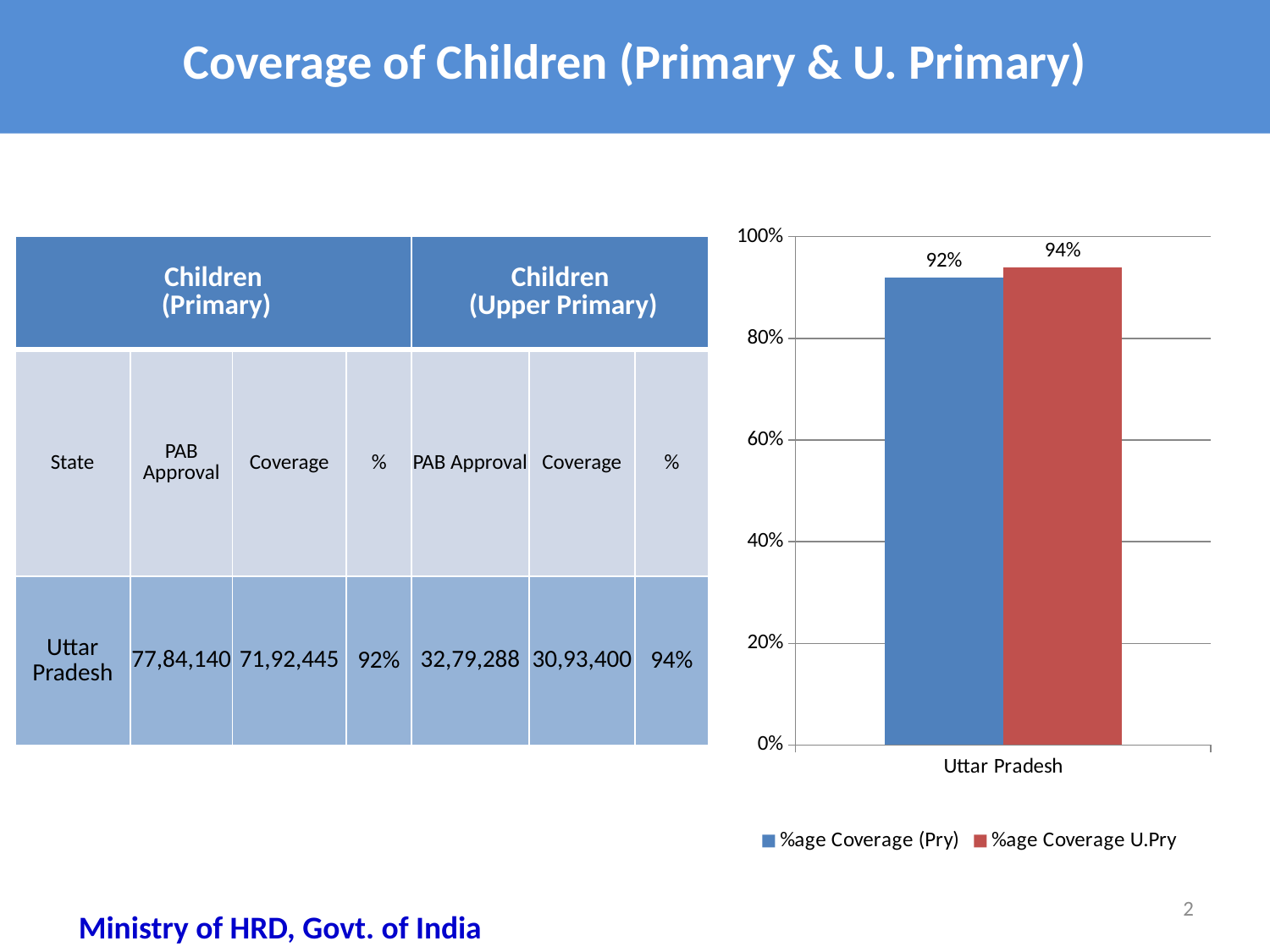
What colour is the bar for %age Coverage U.Pry in the chart? red What is the category label on the x axis of the chart? Uttar Pradesh What kind of chart is shown on the slide? bar chart Which series has the lower value for Uttar Pradesh in the chart? %age Coverage (Pry) How many series does the chart legend list? 2 How many categories are shown on the x axis of the chart? 1 Is the value for %age Coverage (Pry) for Uttar Pradesh greater or less than 80%? greater What is the value of %age Coverage (Pry) for Uttar Pradesh in the chart? 92% Which series has the higher value for Uttar Pradesh in the chart? %age Coverage U.Pry What is the difference between %age Coverage U.Pry and %age Coverage (Pry) for Uttar Pradesh in the chart? 2% Is the value for %age Coverage U.Pry for Uttar Pradesh greater or less than 100%? less What is the value of %age Coverage U.Pry for Uttar Pradesh in the chart? 94%